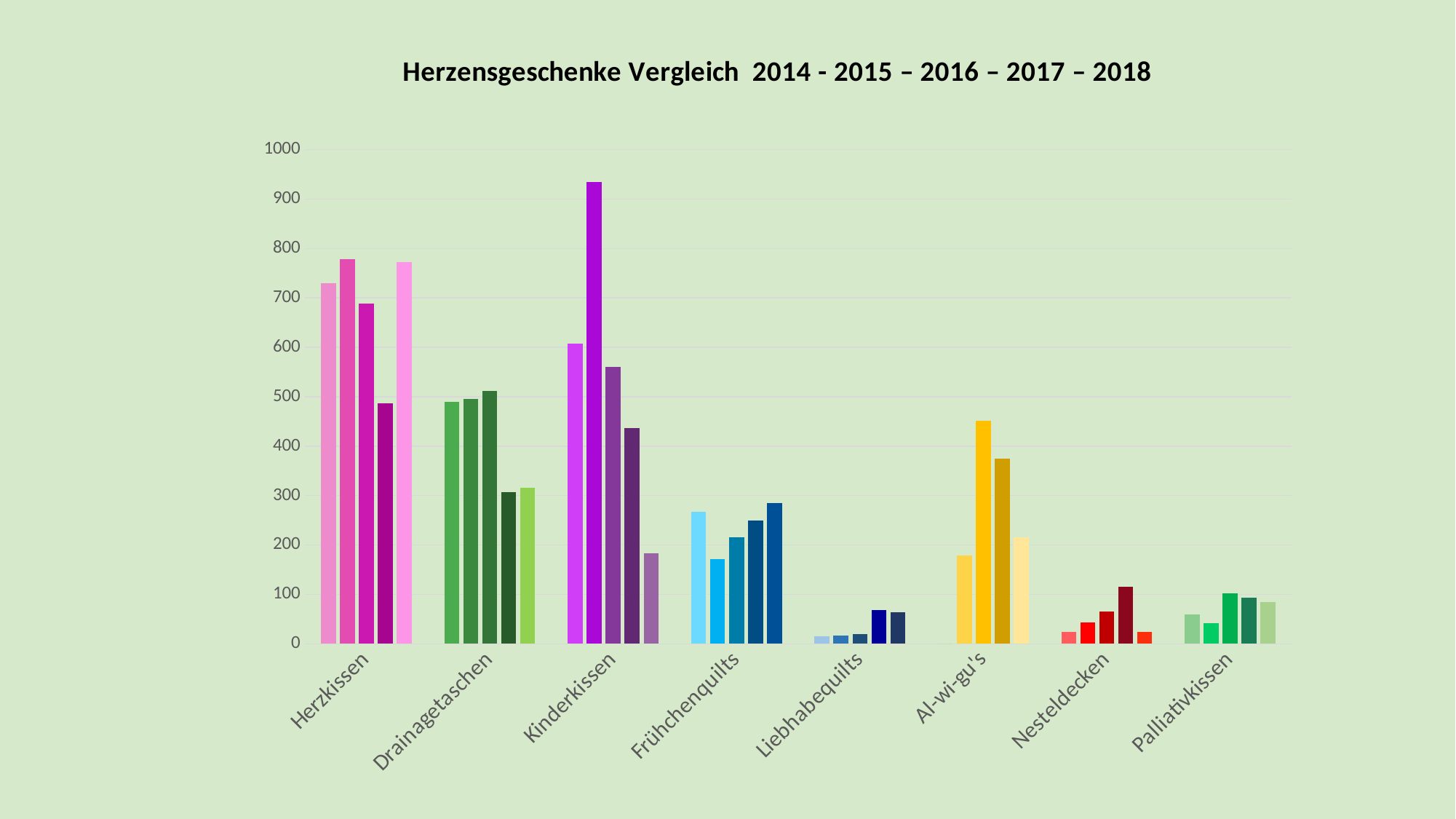
Are all the bars for Liebhabequilts greater or less than 100? less What is the title of the chart? Herzensgeschenke Vergleich 2014 - 2015 – 2016 – 2017 – 2018 Which category has the lowest bars overall? Liebhabequilts How many categories are shown on the x axis? 8 Is the tallest bar for Al-wi-gu's greater or less than 400? greater Which category contains the tallest bar in the chart? Kinderkissen Is the tallest bar for Kinderkissen greater or less than 900? greater Which category has the taller maximum bar, Al-wi-gu's or Frühchenquilts? Al-wi-gu's What kind of chart is shown on the slide? bar chart How many bars are plotted for each category? 5